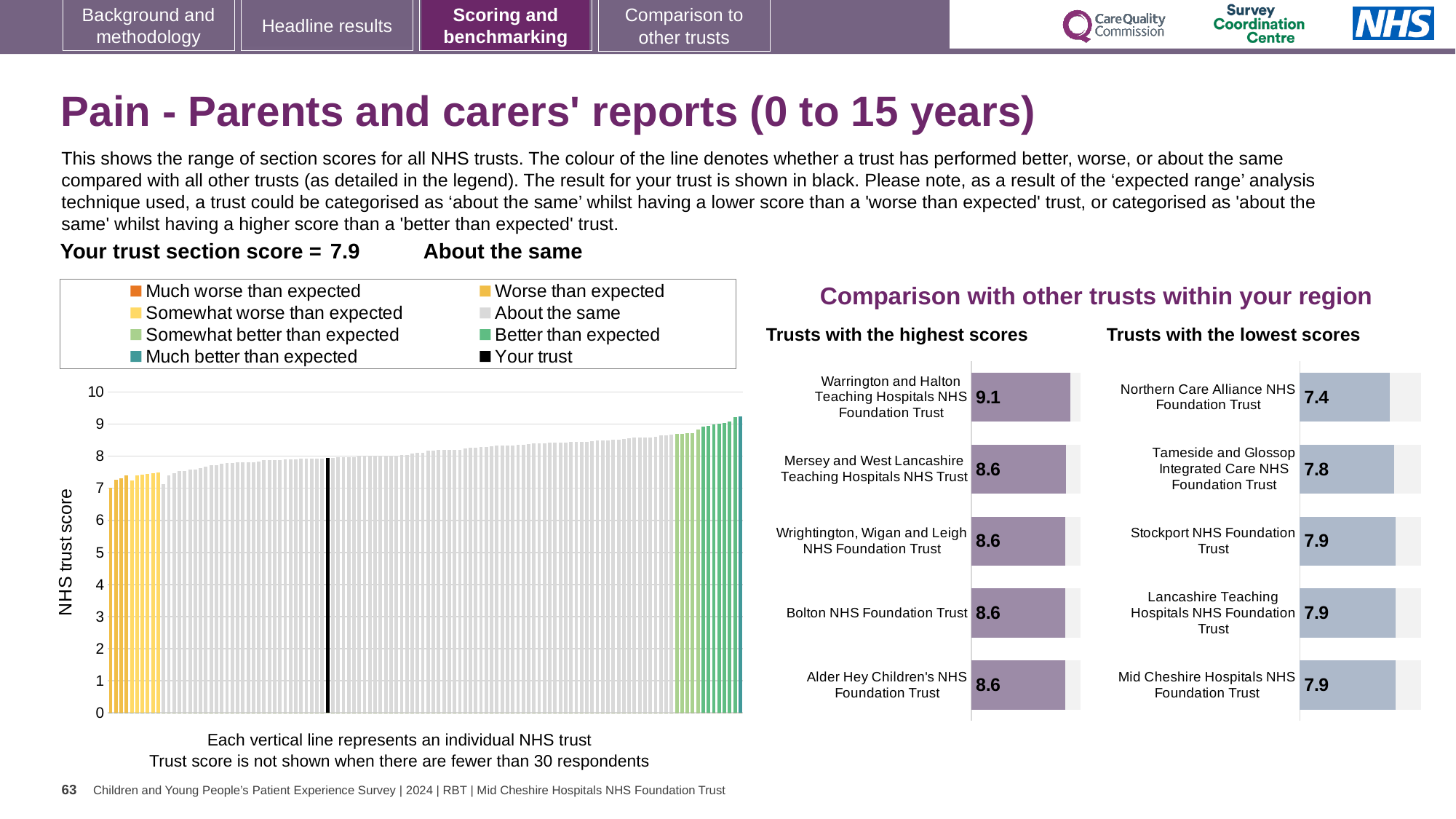
In the 'Trusts with the lowest scores' chart, which trust has the lowest score? Northern Care Alliance NHS Foundation Trust In the 'Trusts with the highest scores' chart, what is the score for Warrington and Halton Teaching Hospitals NHS Foundation Trust? 9.1 In the NHS trust score chart on the left, do the bar heights rise or fall from left to right? Rise In the 'Trusts with the lowest scores' chart, what is the difference between the scores of Mid Cheshire Hospitals NHS Foundation Trust and Northern Care Alliance NHS Foundation Trust? 0.5 What kind of chart is the NHS trust score chart on the left of the slide? Bar chart How many trusts are shown in the 'Trusts with the highest scores' chart? 5 In the NHS trust score chart on the left, is the value of the leftmost (lowest) bar greater or less than 6? greater In the 'Trusts with the highest scores' chart, which trust has the highest score? Warrington and Halton Teaching Hospitals NHS Foundation Trust In the 'Trusts with the lowest scores' chart, what is the score for Northern Care Alliance NHS Foundation Trust? 7.4 In the 'Trusts with the lowest scores' chart, which has the larger score: Tameside and Glossop Integrated Care NHS Foundation Trust or Northern Care Alliance NHS Foundation Trust? Tameside and Glossop Integrated Care NHS Foundation Trust How many entries does the legend of the NHS trust score chart on the left list? 8 In the 'Trusts with the highest scores' chart, what is the difference between the scores of Warrington and Halton Teaching Hospitals NHS Foundation Trust and Bolton NHS Foundation Trust? 0.5